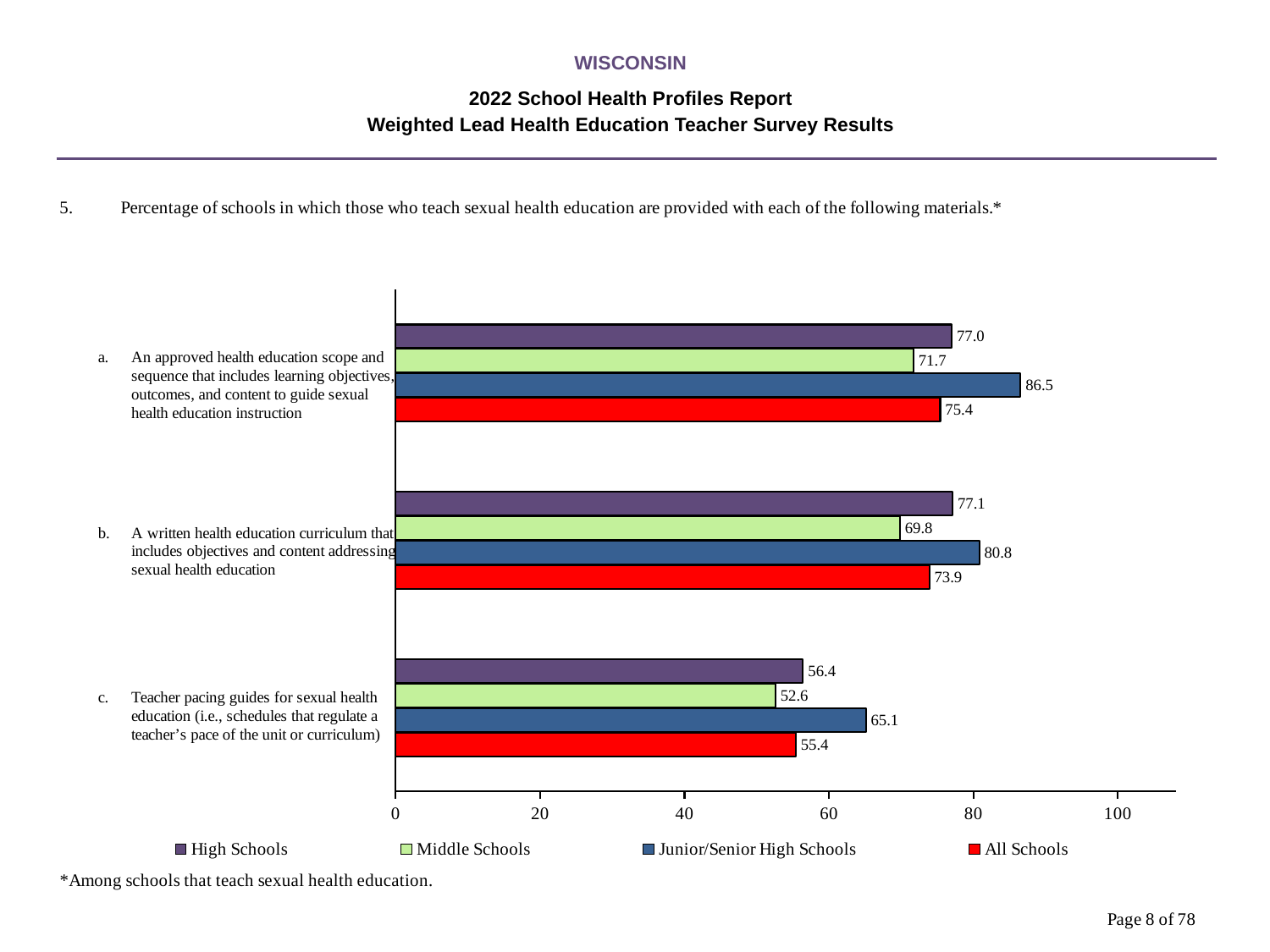
Which school type has the lowest value for item c (teacher pacing guides)? Middle Schools Which colour represents All Schools in the legend? Red How many series does the legend list? 4 How many items (categories) are shown on the chart? 3 Is the Junior/Senior High Schools value for item c greater or less than 60? greater What is the value for Middle Schools for item c (teacher pacing guides for sexual health education)? 52.6 What is the difference between the Junior/Senior High Schools and Middle Schools values for item a? 14.8 What kind of chart is shown on the slide? Bar chart What is the value for Junior/Senior High Schools for item a (approved health education scope and sequence)? 86.5 What is the value for All Schools for item b (written health education curriculum)? 73.9 Which is larger for item c: the High Schools value or the All Schools value? High Schools Which school type has the highest value for item b (written health education curriculum)? Junior/Senior High Schools